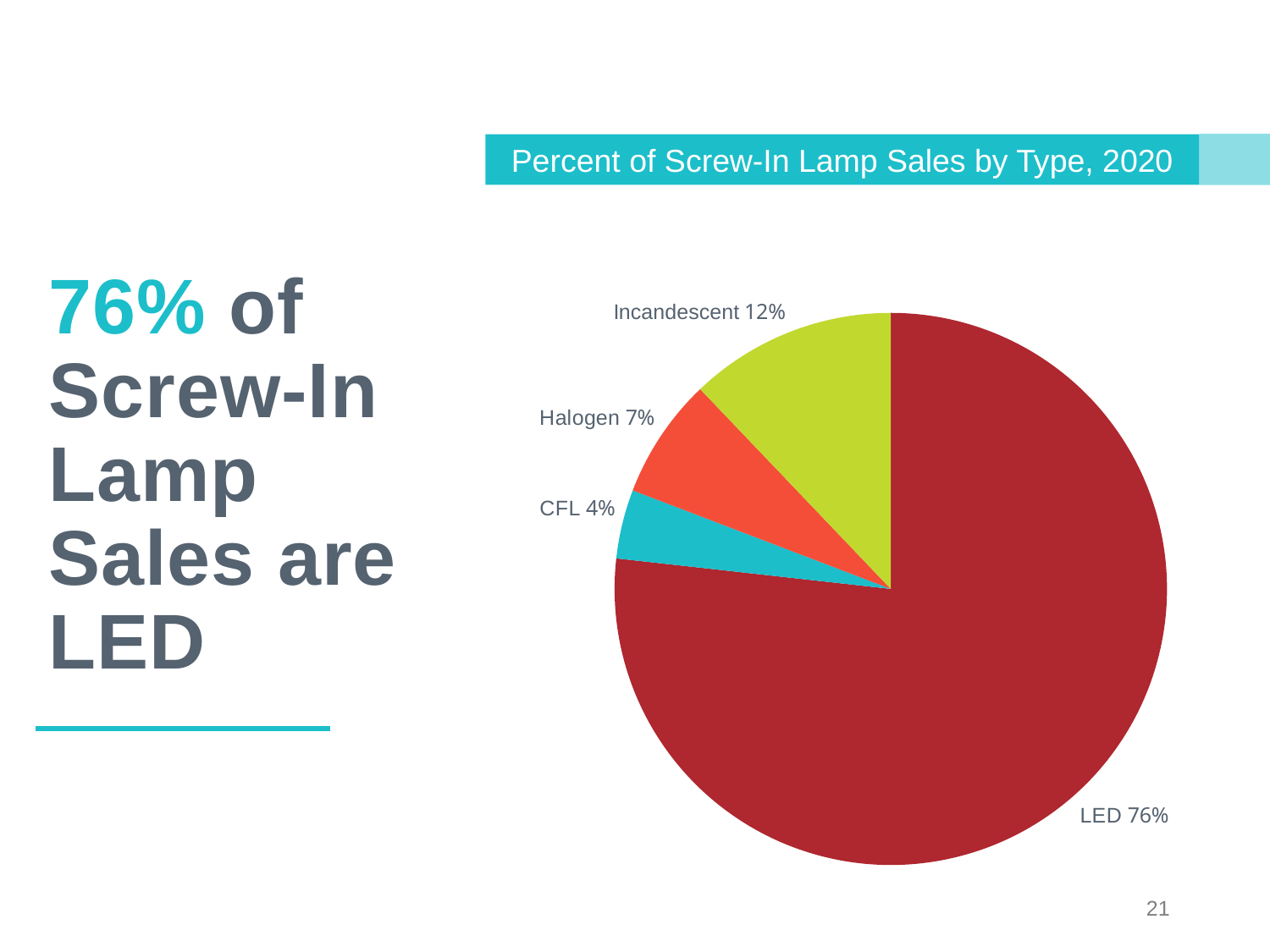
What share of screw-in lamp sales is LED? 76% What is the difference in percentage points between the Incandescent and Halogen shares? 5% What type of chart is shown on the slide? Pie chart Which has a larger share of sales, Halogen or CFL? Halogen How many lamp types are shown in the pie chart? 4 What share of screw-in lamp sales is CFL? 4% What is the title of the chart? Percent of Screw-In Lamp Sales by Type, 2020 What colour is the LED slice of the pie chart? Red Which lamp type has the largest share of sales? LED What share of screw-in lamp sales is Halogen? 7% Which lamp type has the smallest share of sales? CFL